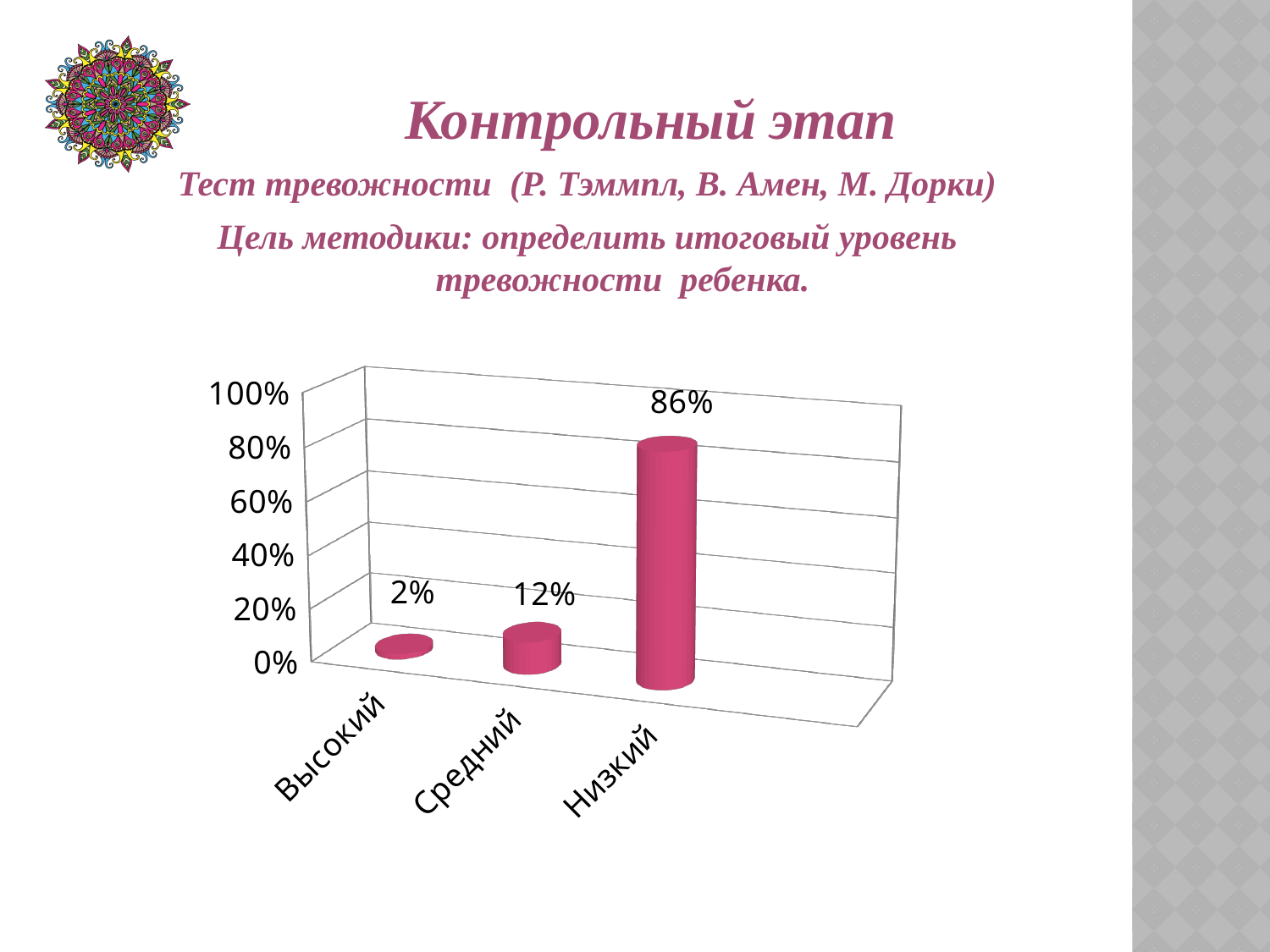
Which category has the highest value? Низкий What is the difference between the values for Низкий and Средний? 74% Do the values rise or fall from left to right along the x axis? rise Is the value for Низкий greater or less than 80%? greater How many categories are shown on the x axis? 3 What kind of chart is shown on the slide? bar chart Which category has the lowest value? Высокий What is the value for Средний? 12% What is the difference between the values for Средний and Высокий? 10% Which is larger, the value for Средний or the value for Высокий? Средний What is the value for Высокий? 2% What is the value for Низкий? 86%